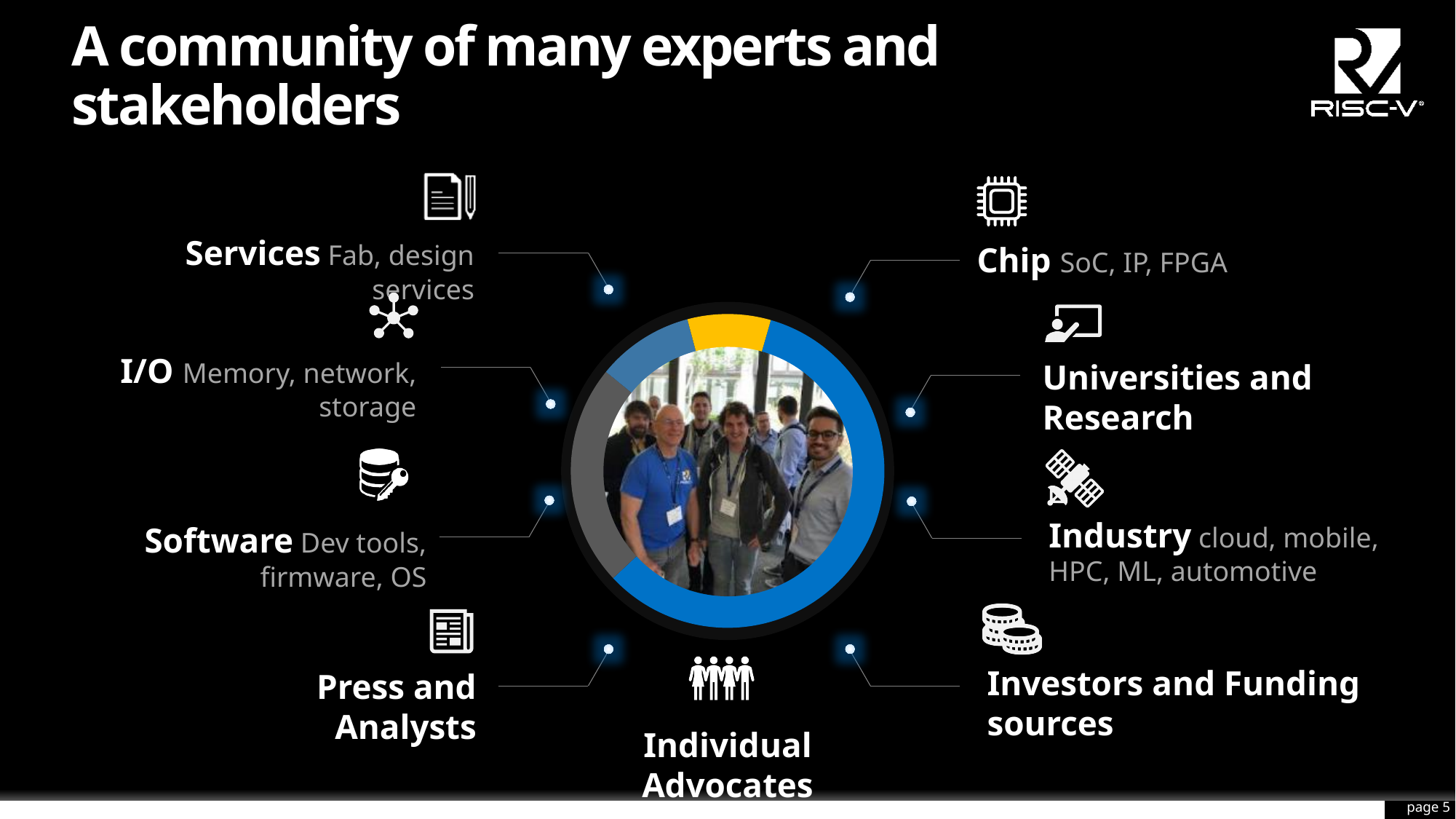
Does the ring chart around the photo show any data labels or values? No Is the blue segment of the ring larger or smaller than the gray segment? larger Which colour segment of the ring around the photo is the smallest? yellow Which colour segment of the ring around the photo is the largest? blue Does the ring chart around the photo have a legend? No What kind of chart is the ring around the photo in the centre of the slide? doughnut chart How many coloured segments make up the ring around the photo? 4